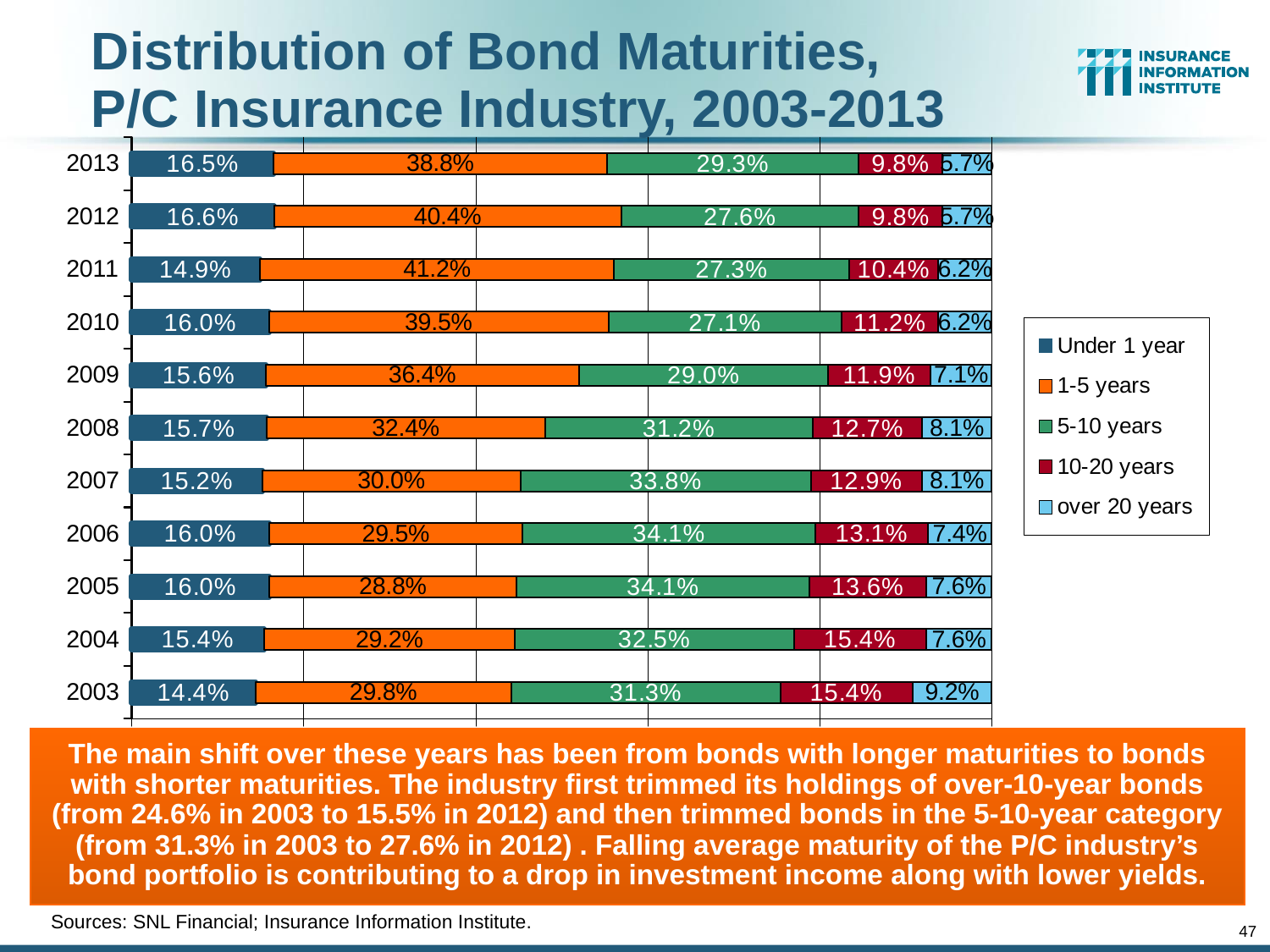
Which maturity category is listed first in the legend? Under 1 year What type of chart is shown on the slide? Stacked bar chart How many years are shown on the chart? 11 In which year was the 1-5 years share the highest? 2011 In which year was the Under 1 year share the lowest? 2003 What share of bonds had a 5-10 year maturity in 2003? 31.3% What share of bonds had a 1-5 year maturity in 2011? 41.2% What share of bonds had a maturity of over 20 years in 2003? 9.2% Did the 1-5 years share rise or fall between 2003 and 2013? Rise Which year had a larger 5-10 years share, 2007 or 2008? 2007 By how many percentage points did the 10-20 years share fall from 2003 to 2013? 5.6 percentage points How many maturity categories does the legend list? 5